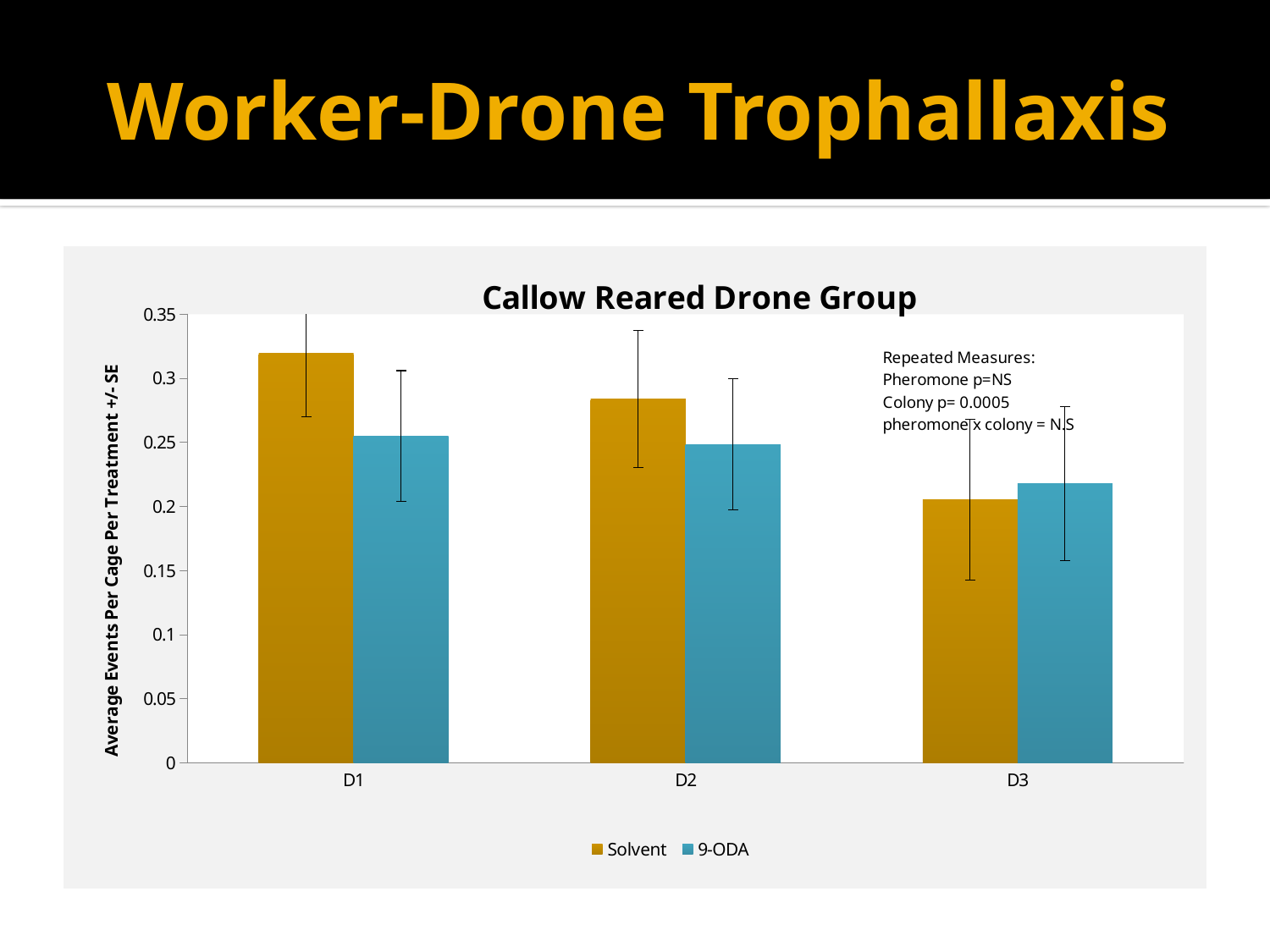
For which drone group is the Solvent value lowest? D3 Which series is shown in gold/orange bars? Solvent Is the 9-ODA value for D1 greater or less than 0.3? less Is the Solvent value for D1 greater or less than 0.3? greater What kind of chart is shown on the slide? bar chart Is the Solvent value for D2 greater or less than 0.25? greater How many series does the legend list? 2 What is the title of the chart? Callow Reared Drone Group How many drone groups are shown on the x axis? 3 For D1, which is larger, the Solvent value or the 9-ODA value? Solvent For which drone group is the Solvent value highest? D1